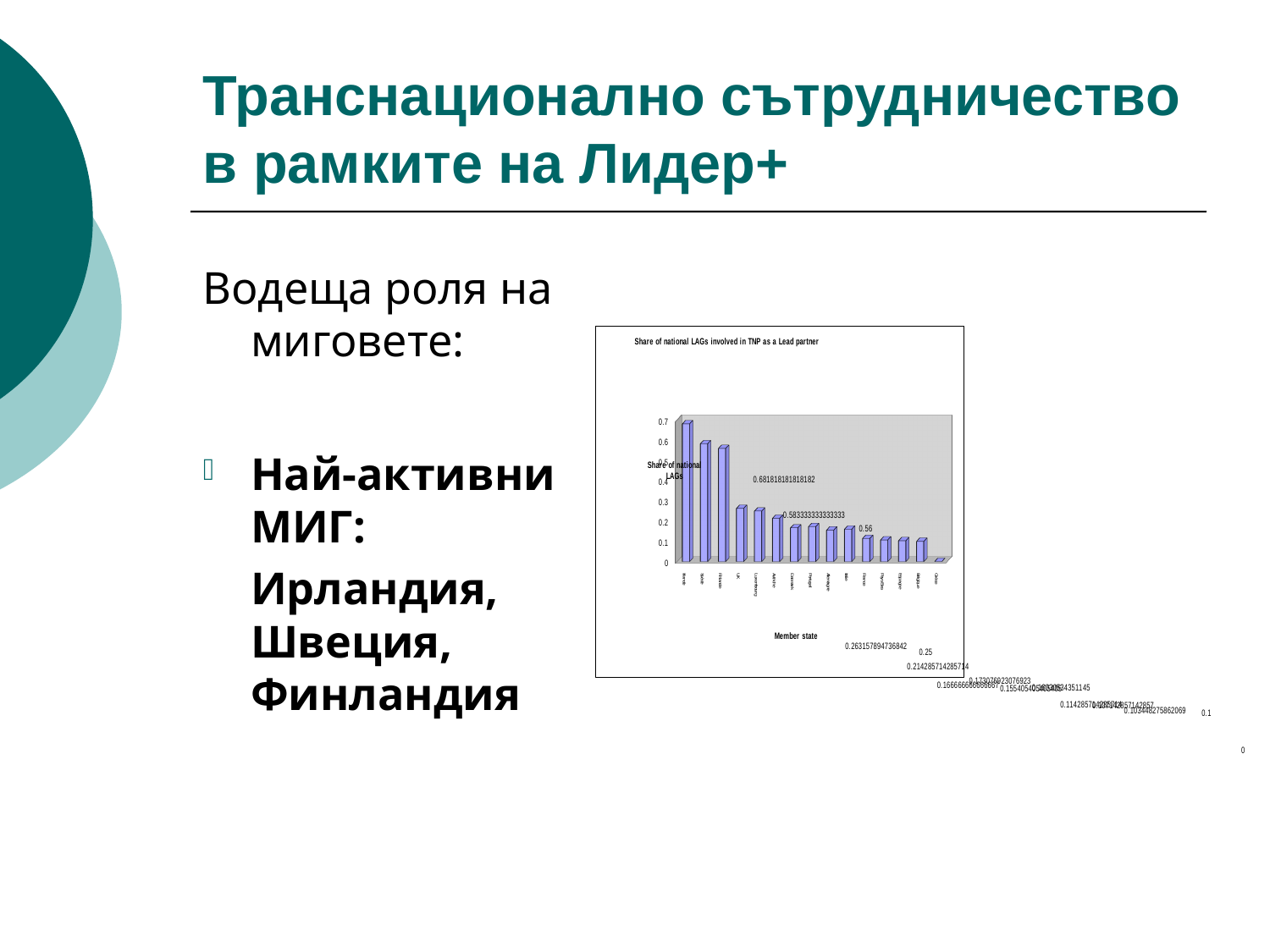
Is the value of the last bar on the right greater or less than 0.1? less Which member state has the highest share of national LAGs involved in TNP as a lead partner? Irlande What kind of chart is shown on the slide? bar chart What is the title of the chart? Share of national LAGs involved in TNP as a Lead partner What is the value of the tallest bar in the chart? 0.681818181818182 Is the value of the fourth bar from the left greater or less than 0.4? less Which is larger, the first bar from the left or the fourth bar from the left? the first bar How many bars (member states) are plotted in the chart? 15 Do the bar values rise or fall from left to right along the x axis? fall Is the value of the tallest bar greater or less than 0.5? greater What is the title of the x axis of the chart? Member state